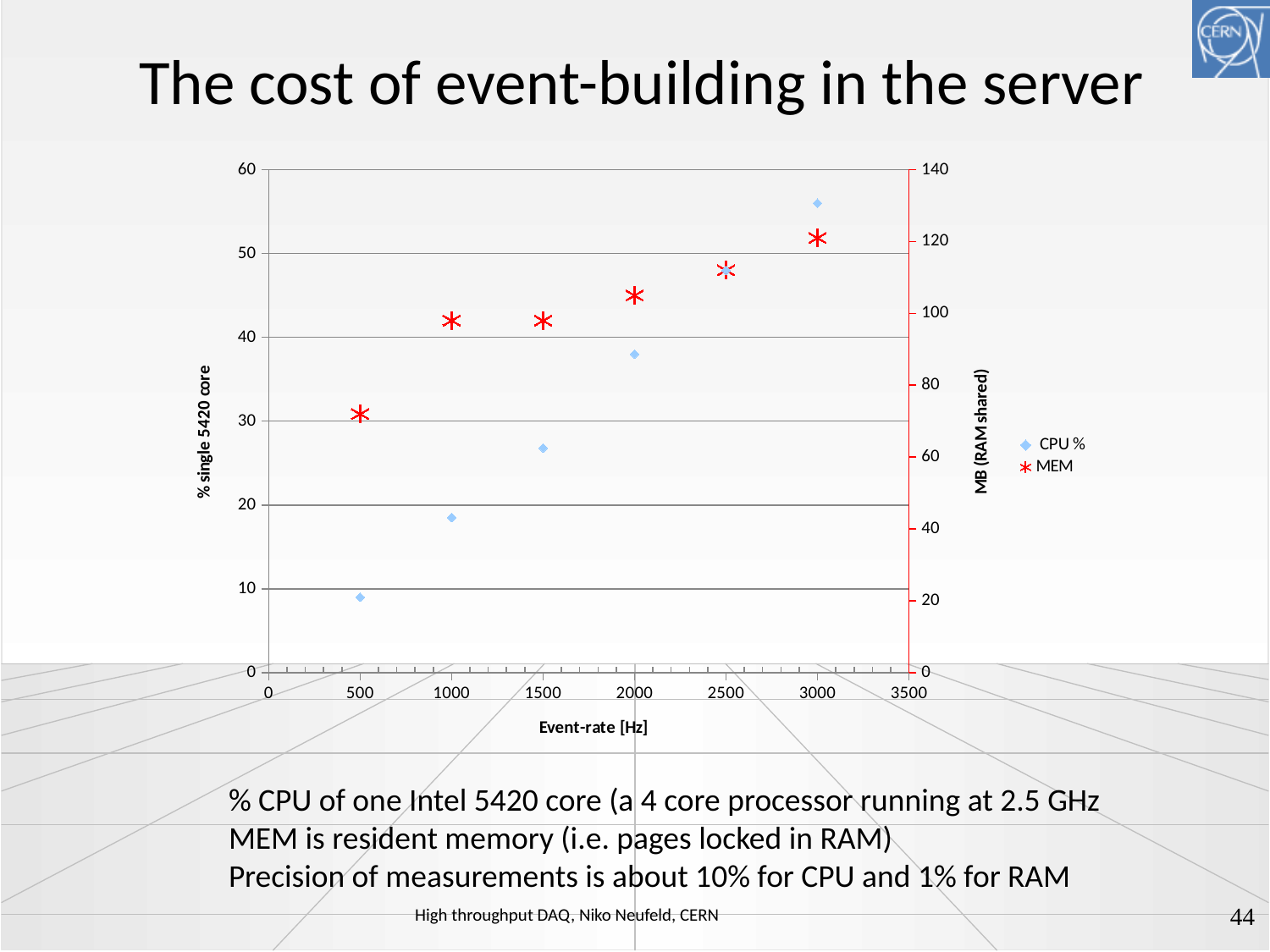
Which is larger: the MEM value at 500 Hz or the MEM value at 2000 Hz? 2000 Hz Is the MEM value at an event-rate of 3000 Hz greater or less than 100? greater Does the CPU % value rise or fall as the event-rate increases? rise At which event-rate is the CPU % value highest? 3000 Is the CPU % value at an event-rate of 3000 Hz greater or less than 50? greater What is the title of the x axis? Event-rate [Hz] Is the MEM value at an event-rate of 500 Hz greater or less than 80? less What kind of chart is shown on the slide? scatter chart How many series does the legend list? 2 At which event-rate is the MEM value lowest? 500 How many data points are plotted for the CPU % series? 6